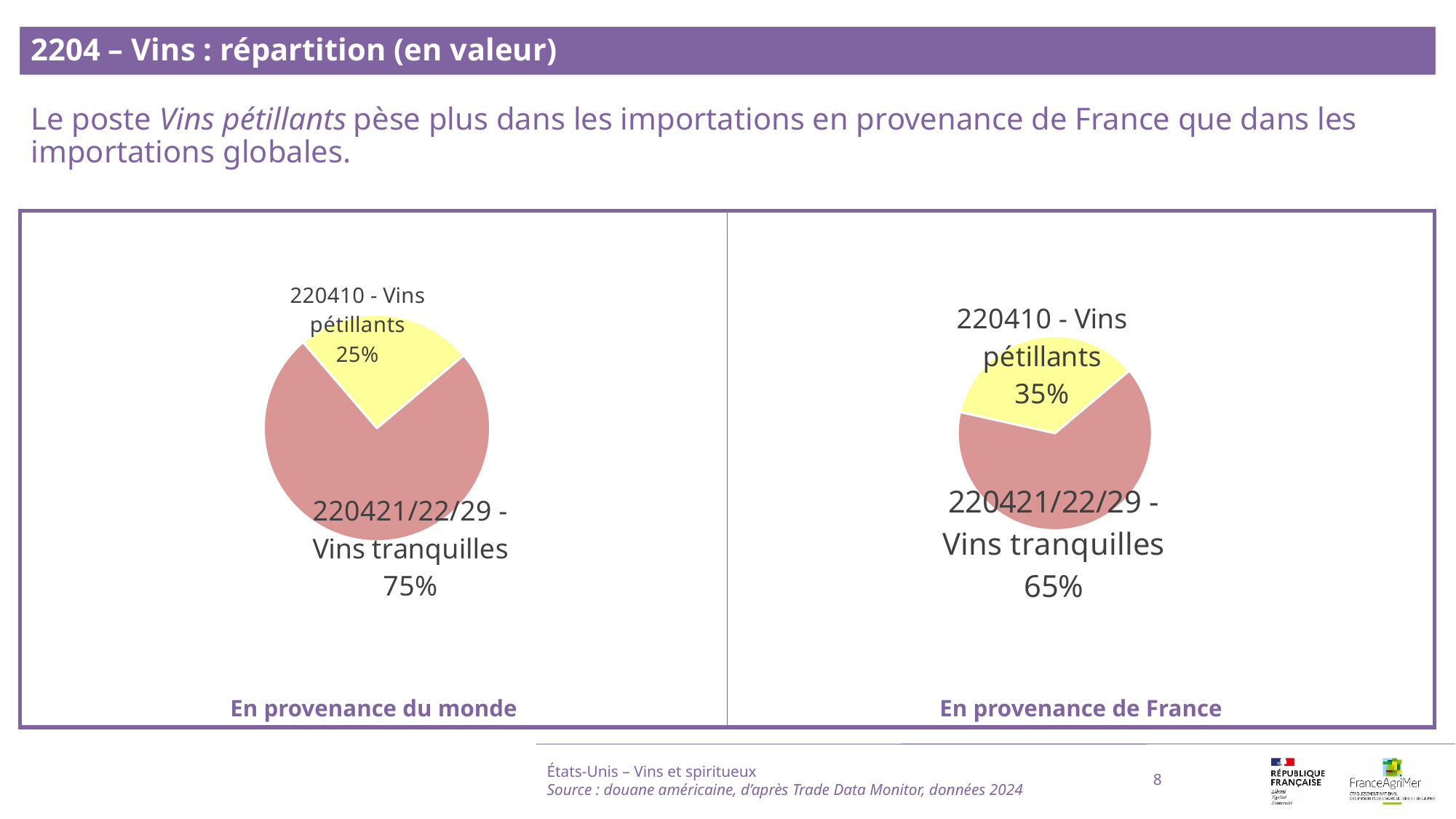
In the 'En provenance du monde' chart, what share does '220421/22/29 - Vins tranquilles' have? 75% Is the share of Vins pétillants larger in the 'En provenance du monde' chart or in the 'En provenance de France' chart? En provenance de France In the 'En provenance du monde' chart, what colour is the Vins pétillants slice? Yellow In the 'En provenance de France' chart, what share does '220410 - Vins pétillants' have? 35% In the 'En provenance du monde' chart, which category has the largest slice? 220421/22/29 - Vins tranquilles What type of chart is the 'En provenance du monde' chart? Pie chart In the 'En provenance de France' chart, what share does '220421/22/29 - Vins tranquilles' have? 65% In the 'En provenance de France' chart, what is the difference between the shares of Vins tranquilles and Vins pétillants? 30% In the 'En provenance de France' chart, which category has the smallest slice? 220410 - Vins pétillants In the 'En provenance du monde' chart, what is the difference between the shares of Vins tranquilles and Vins pétillants? 50% How many categories are shown in the 'En provenance de France' chart? 2